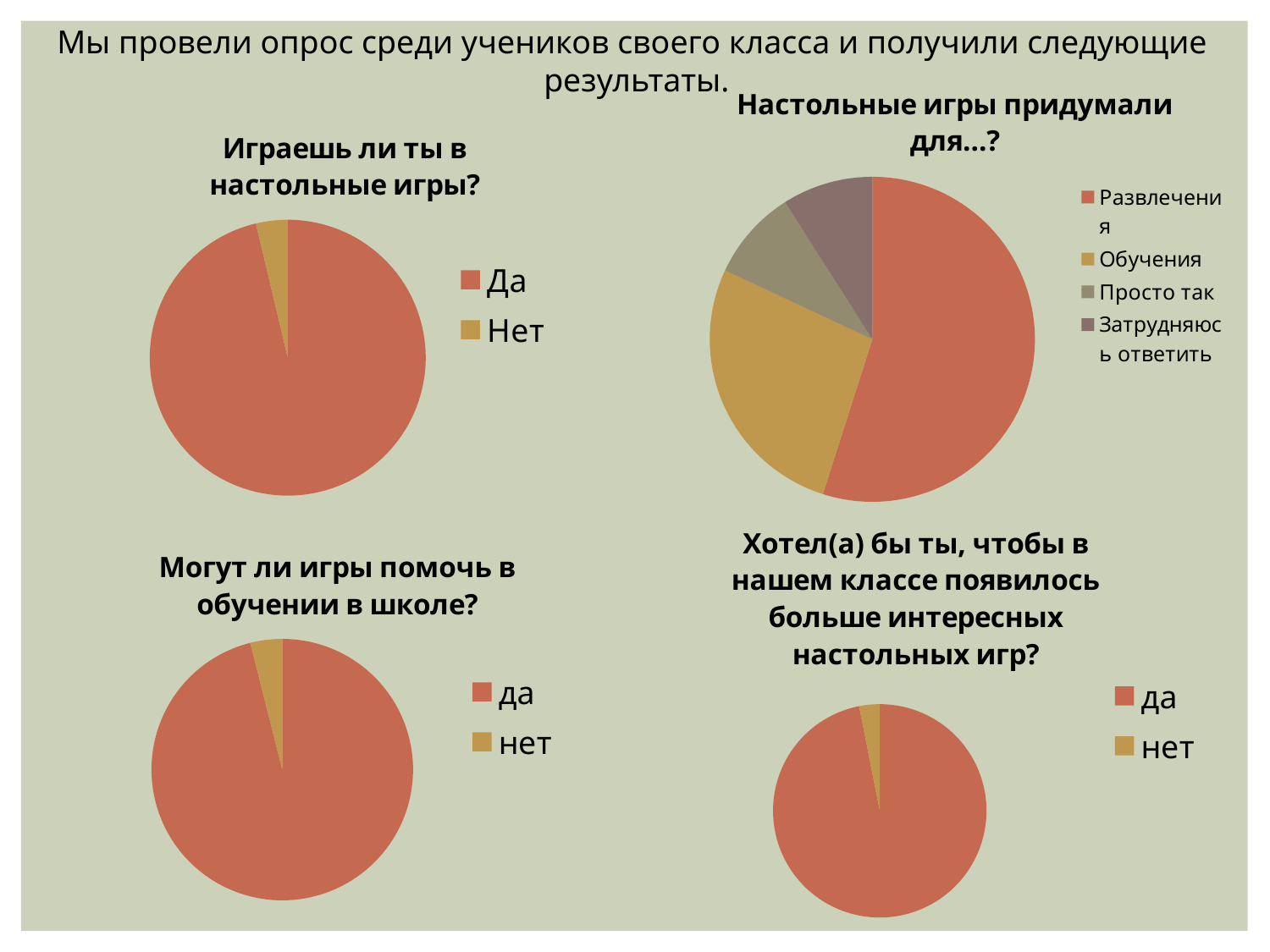
What kind of chart is used for "Играешь ли ты в настольные игры?"? pie chart How many entries does the legend of the chart "Настольные игры придумали для...?" list? 4 How many entries does the legend of the chart "Могут ли игры помочь в обучении в школе?" list? 2 In the chart "Настольные игры придумали для...?", what colour is the slice for Обучения? gold In the chart "Хотел(а) бы ты, чтобы в нашем классе появилось больше интересных настольных игр?", which answer has the smallest slice? нет In the chart "Играешь ли ты в настольные игры?", which answer has the largest slice? Да How many pie charts are shown on the slide? 4 In the chart "Играешь ли ты в настольные игры?", which answer has the smallest slice? Нет In the chart "Настольные игры придумали для...?", which category has the largest slice? Развлечения In the chart "Настольные игры придумали для...?", which slice is larger: Обучения or Просто так? Обучения In the chart "Могут ли игры помочь в обучении в школе?", which answer has the largest slice? да